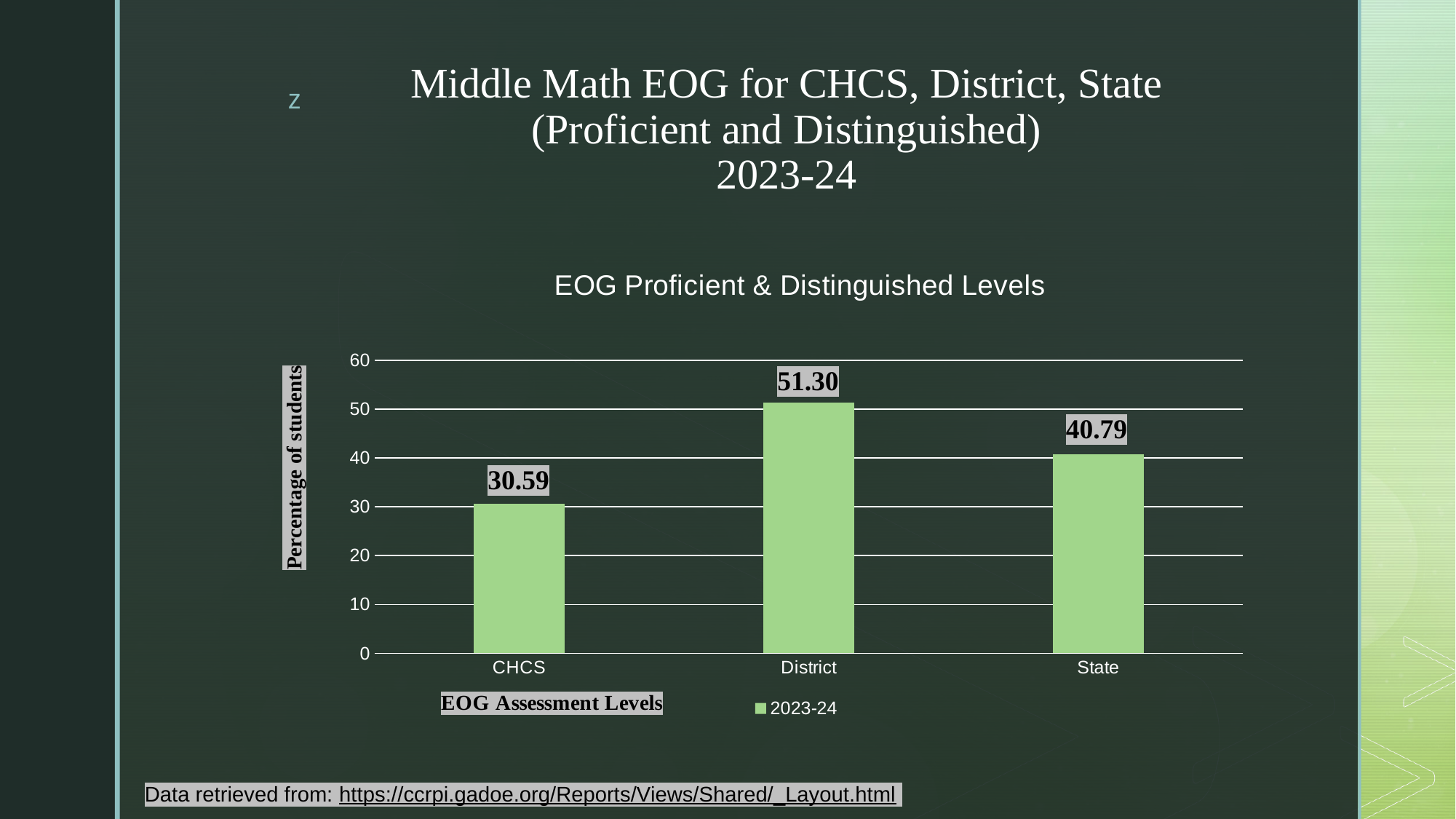
Is the value for District greater or less than 50? greater What is the difference between the State value and the CHCS value? 10.20 What is the value for District? 51.30 What kind of chart is shown? bar chart What is the value for CHCS? 30.59 How many categories are shown on the x axis? 3 What is the value for State? 40.79 Which is larger, the value for State or the value for CHCS? State Which category has the highest value? District What is the difference between the District value and the CHCS value? 20.71 Which category has the lowest value? CHCS How many series does the legend list? 1